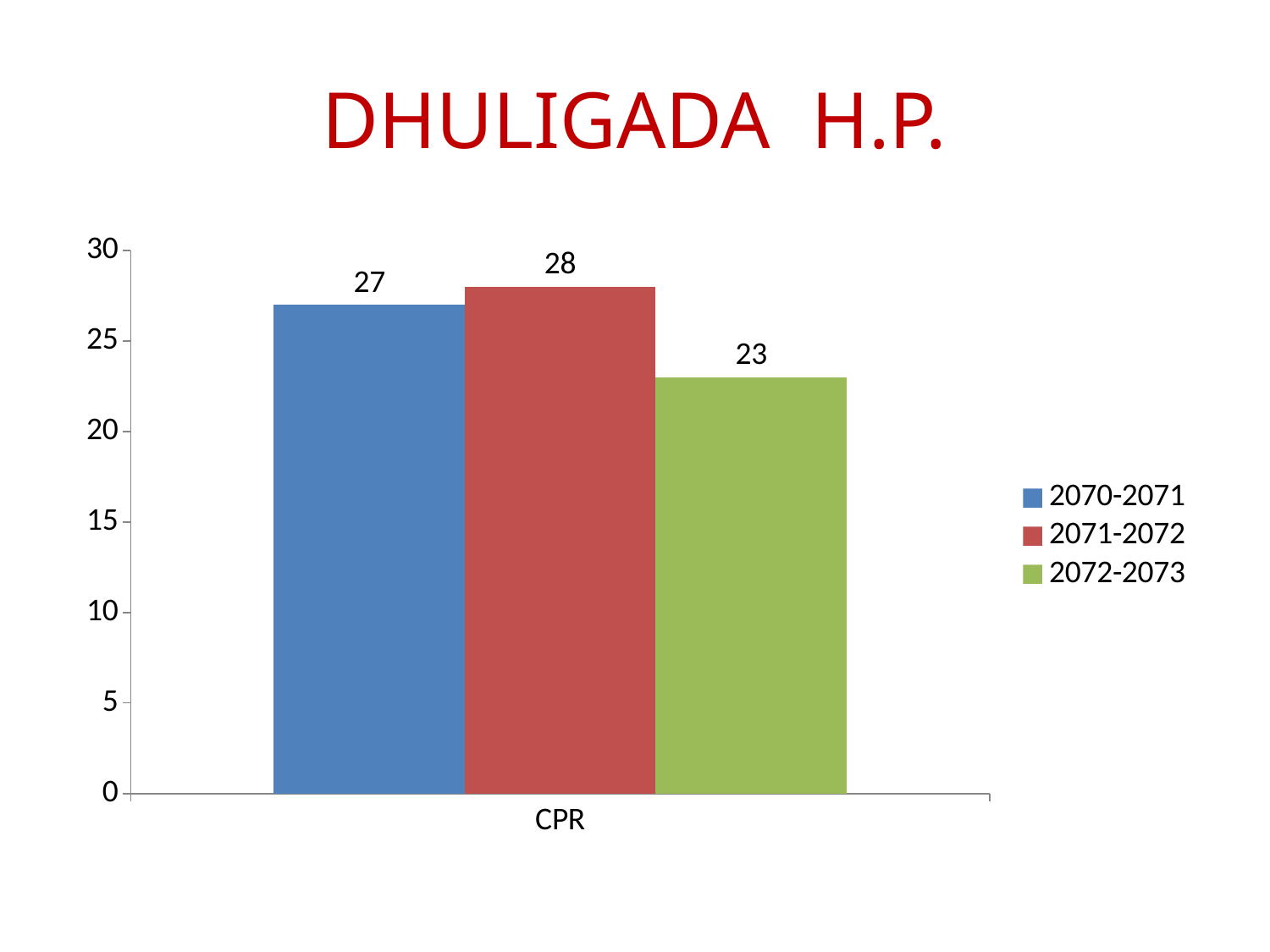
What is the title of the slide? DHULIGADA H.P. Which series has the highest CPR value? 2071-2072 What is the CPR value for 2071-2072? 28 What is the CPR value for 2070-2071? 27 What is the CPR value for 2072-2073? 23 Is the CPR value for 2072-2073 greater or less than 25? less What kind of chart is shown on the slide? bar chart Which series has the lowest CPR value? 2072-2073 What is the difference between the CPR values for 2070-2071 and 2072-2073? 4 What is the difference between the CPR values for 2071-2072 and 2072-2073? 5 Which is larger, the CPR value for 2070-2071 or for 2072-2073? 2070-2071 How many series does the legend list? 3